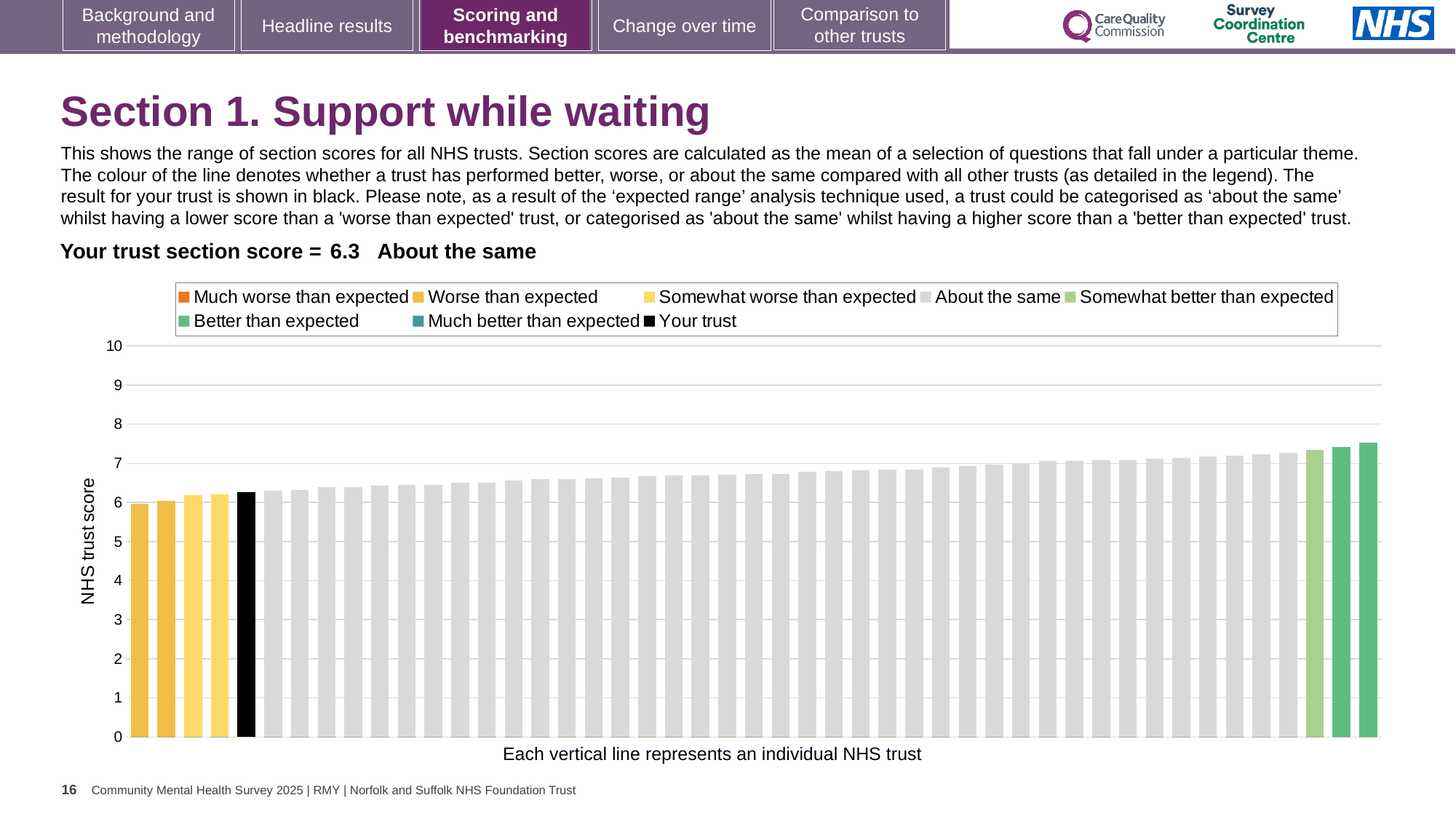
Which category is your trust placed in for this section? About the same Do the bar values rise or fall from left to right along the x axis? rise How many bars are coloured as 'Somewhat better than expected' (light green)? 1 What is the label on the vertical axis of the chart? NHS trust score Is the value of the shortest bar greater or less than 5? greater How many bars are coloured as 'Worse than expected' (dark yellow)? 2 How many bars are coloured as 'Better than expected' (green)? 2 Is the value of the black 'Your trust' bar greater or less than 7? less Is the value of the tallest bar greater or less than 7? greater How many entries does the chart legend list? 8 What kind of chart is shown on the slide? bar chart What is the section score for your trust shown on the slide? 6.3